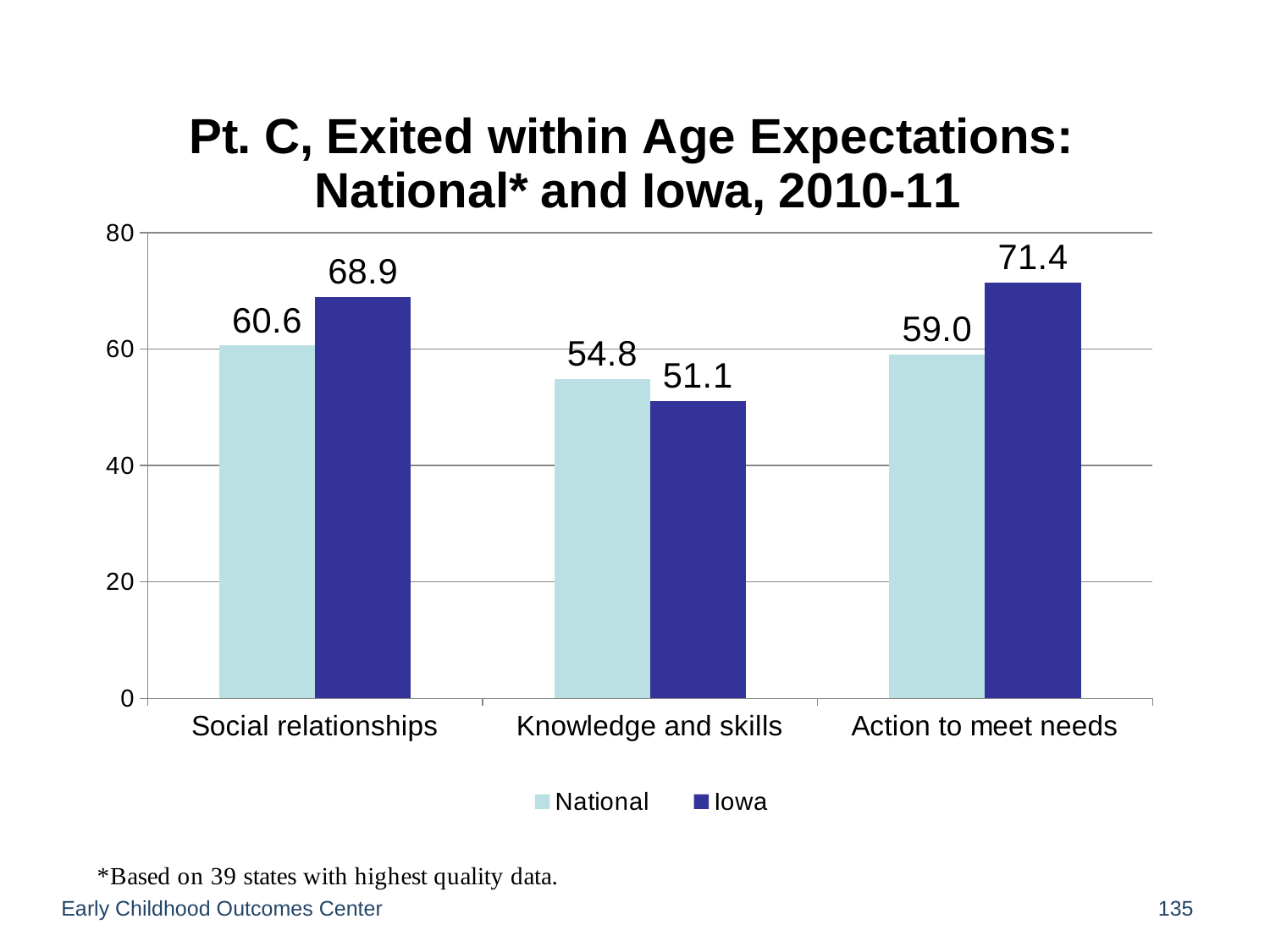
How many categories are shown on the x axis? 3 What is the Iowa value for Knowledge and skills? 51.1 Which category has the lowest National value? Knowledge and skills What is the National value for Social relationships? 60.6 For Knowledge and skills, which is larger: the National value or the Iowa value? National Is the Iowa value for Action to meet needs greater or less than 60? greater Which series is shown in dark blue? Iowa What kind of chart is shown on the slide? bar chart Which category has the highest Iowa value? Action to meet needs How many series does the legend list? 2 What is the difference between the Iowa and National values for Social relationships? 8.3 What is the Iowa value for Action to meet needs? 71.4